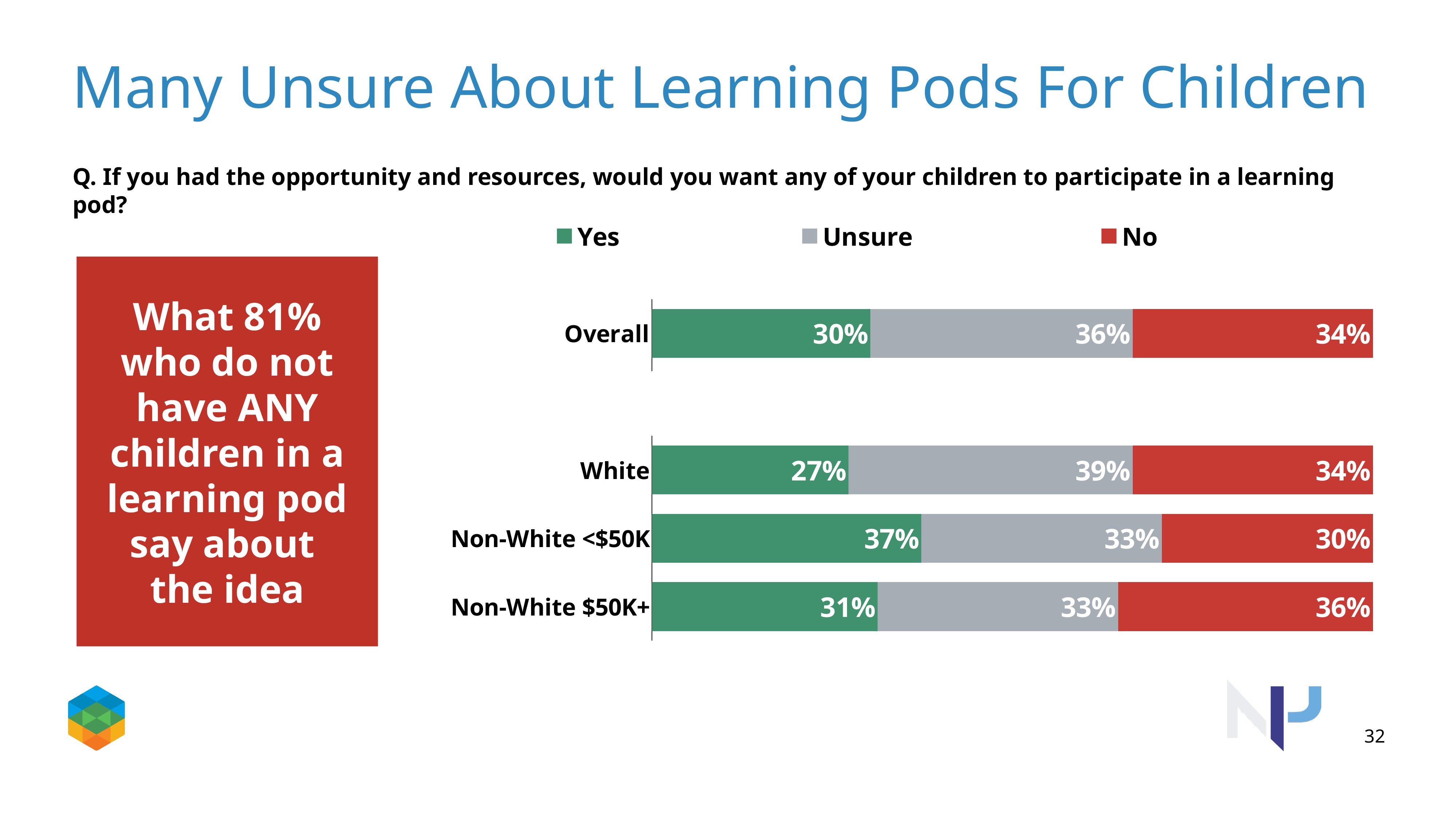
What percentage of Overall respondents answered Yes? 30% Which group has the highest Yes percentage? Non-White <$50K What is the total of the Overall bar (Yes + Unsure + No)? 100% What is the difference between the Unsure percentage for White and for Non-White <$50K? 6% Which is larger: the No percentage for Non-White <$50K or for Non-White $50K+? Non-White $50K+ What kind of chart is shown on the slide? Stacked bar chart What percentage of White respondents answered Unsure? 39% How many series does the legend list? 3 Which group has the lowest Yes percentage? White What percentage of Non-White $50K+ respondents answered No? 36% Which colour represents the Unsure series in the legend? Gray How many groups (categories) are shown in the chart? 4